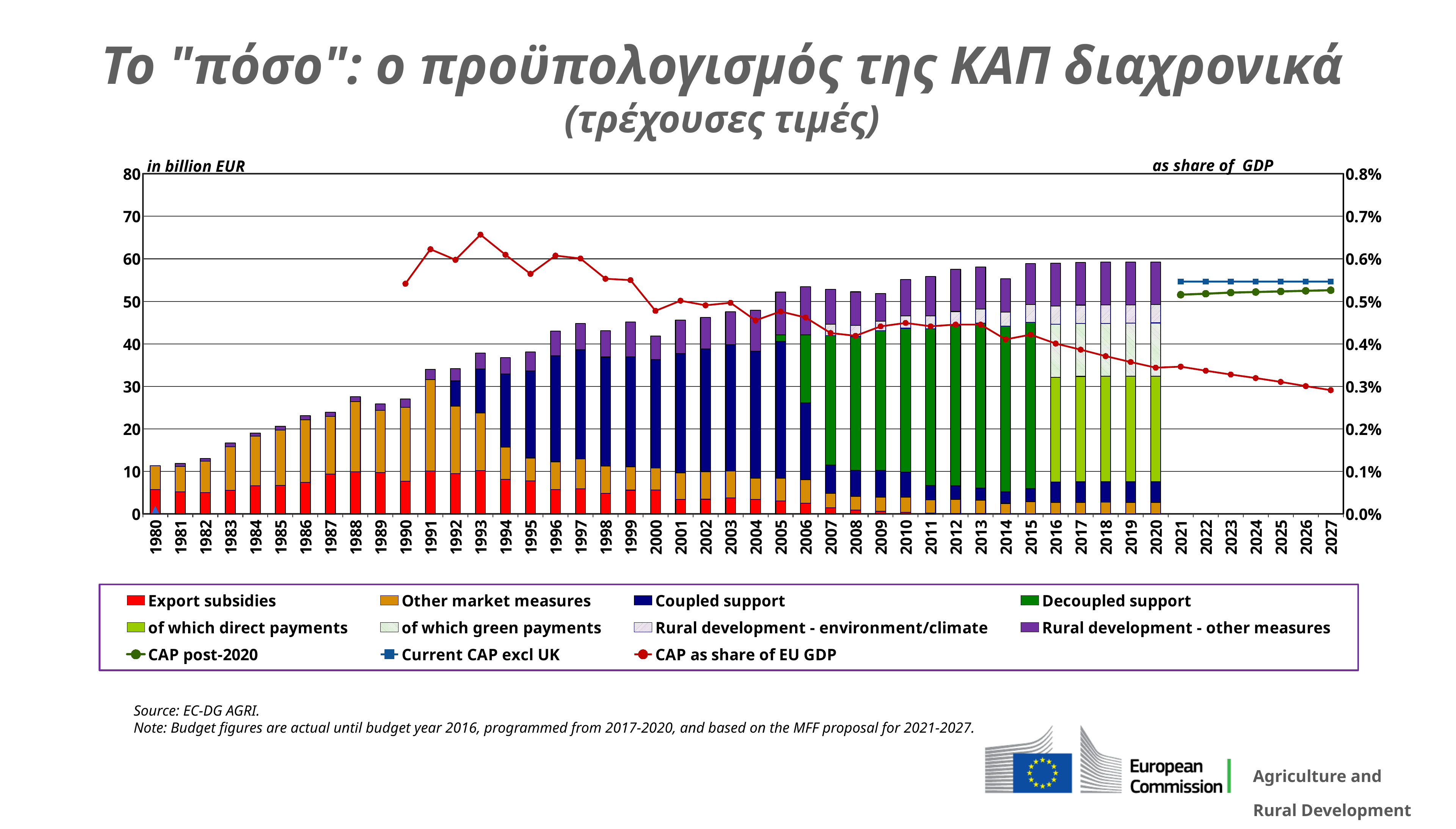
How many years are shown on the x axis of the chart? 48 Is the CAP as share of EU GDP value for 1993 greater or less than 0.6%? greater What colour represents Export subsidies in the legend? Red Which is larger, the total CAP budget bar for 2020 or for 1990? 2020 How many series does the chart legend list? 11 In which year does the CAP as share of EU GDP line reach its highest point? 1993 Is the CAP as share of EU GDP value for 2027 greater or less than 0.4%? less Is the total CAP budget bar for 2020 greater or less than 50 billion EUR? greater Does the CAP as share of EU GDP line rise or fall between 2005 and 2027? fall What kind of chart is shown on the slide? Stacked bar chart with line series